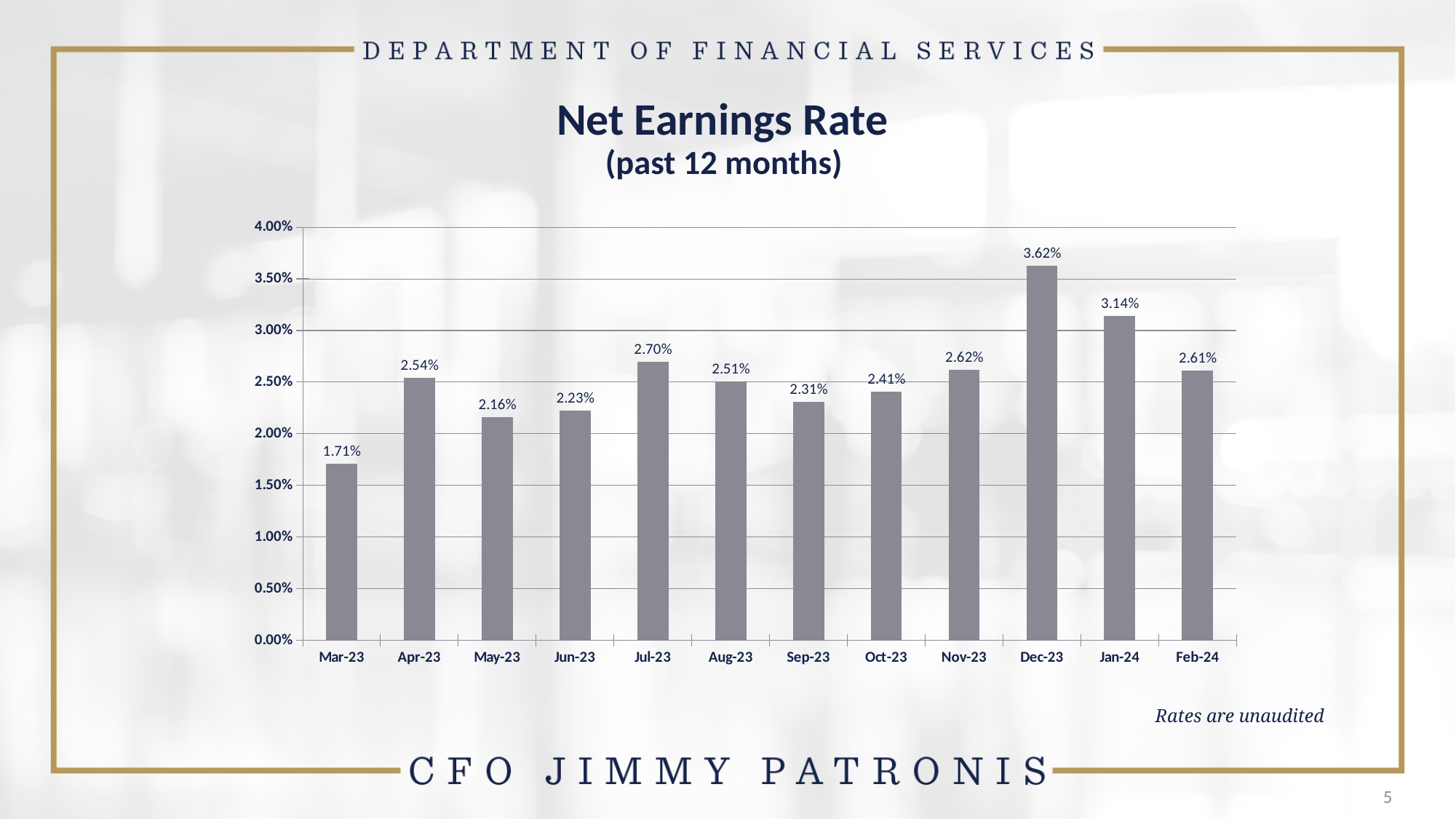
What is the title of the chart? Net Earnings Rate (past 12 months) Which month has a higher net earnings rate, Apr-23 or Aug-23? Apr-23 What is the difference between the net earnings rate in Dec-23 and Jan-24? 0.48% What kind of chart is shown on the slide? Bar chart What is the net earnings rate for Mar-23? 1.71% Is the net earnings rate for Jan-24 greater or less than 3.00%? greater Does the net earnings rate rise or fall from Sep-23 to Dec-23? Rise Which month has the lowest net earnings rate? Mar-23 What is the net earnings rate for Dec-23? 3.62% How many months are shown on the chart? 12 What is the net earnings rate for Jul-23? 2.70% Which month has the highest net earnings rate? Dec-23